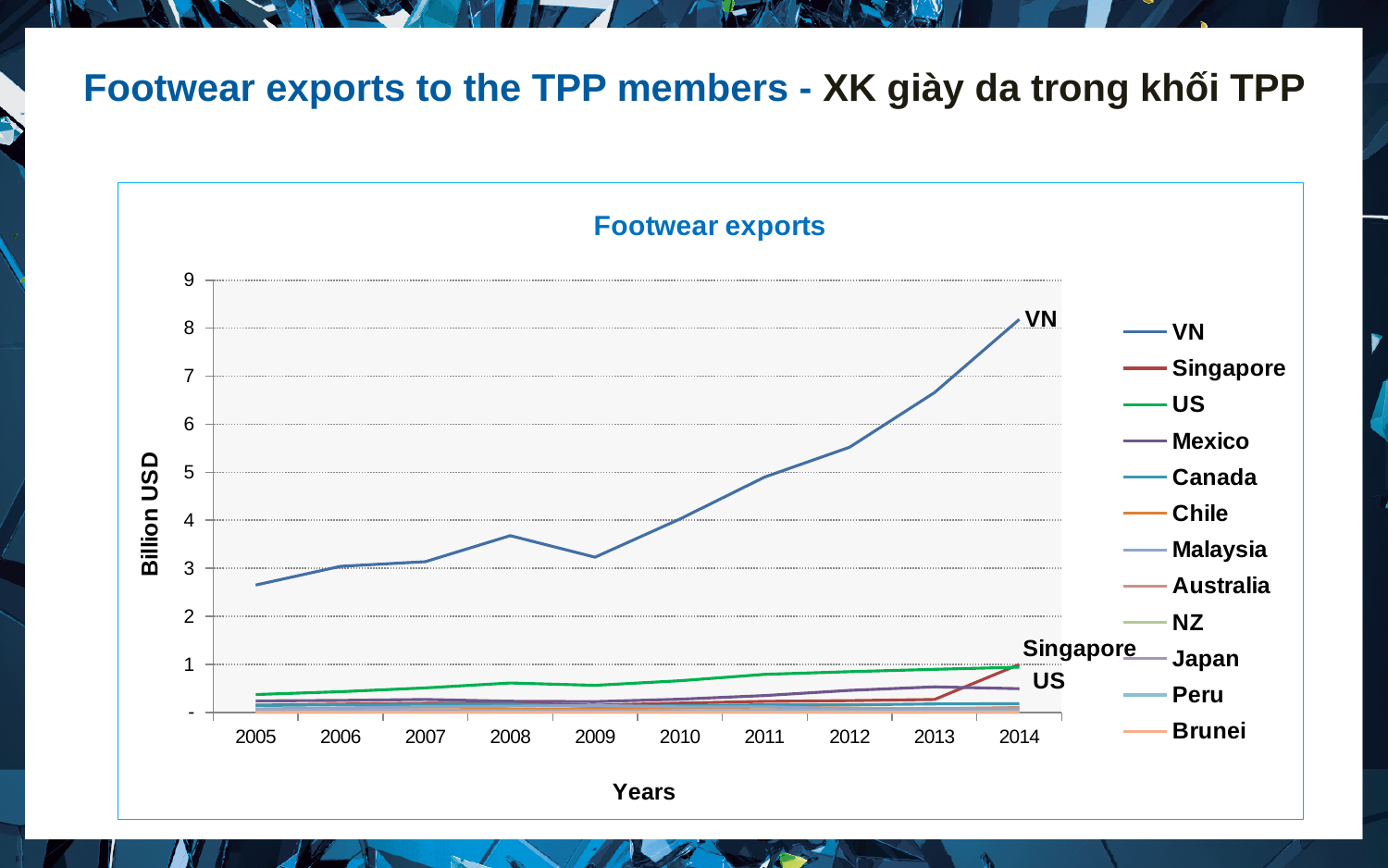
What kind of chart is shown on the slide? line chart What is the title of the chart? Footwear exports What is the label of the vertical axis of the chart? Billion USD Which is larger in 2014, the value for VN or the value for US? VN Is the value for VN in 2014 greater or less than 8? greater Is the value for VN in 2005 greater or less than 3? less How many series does the legend of the chart list? 12 Is the value for VN in 2012 greater or less than 5? greater Which series has the highest footwear exports in 2014? VN Does the VN line rise or fall overall from 2005 to 2014? rise How many years are plotted along the x axis of the chart? 10